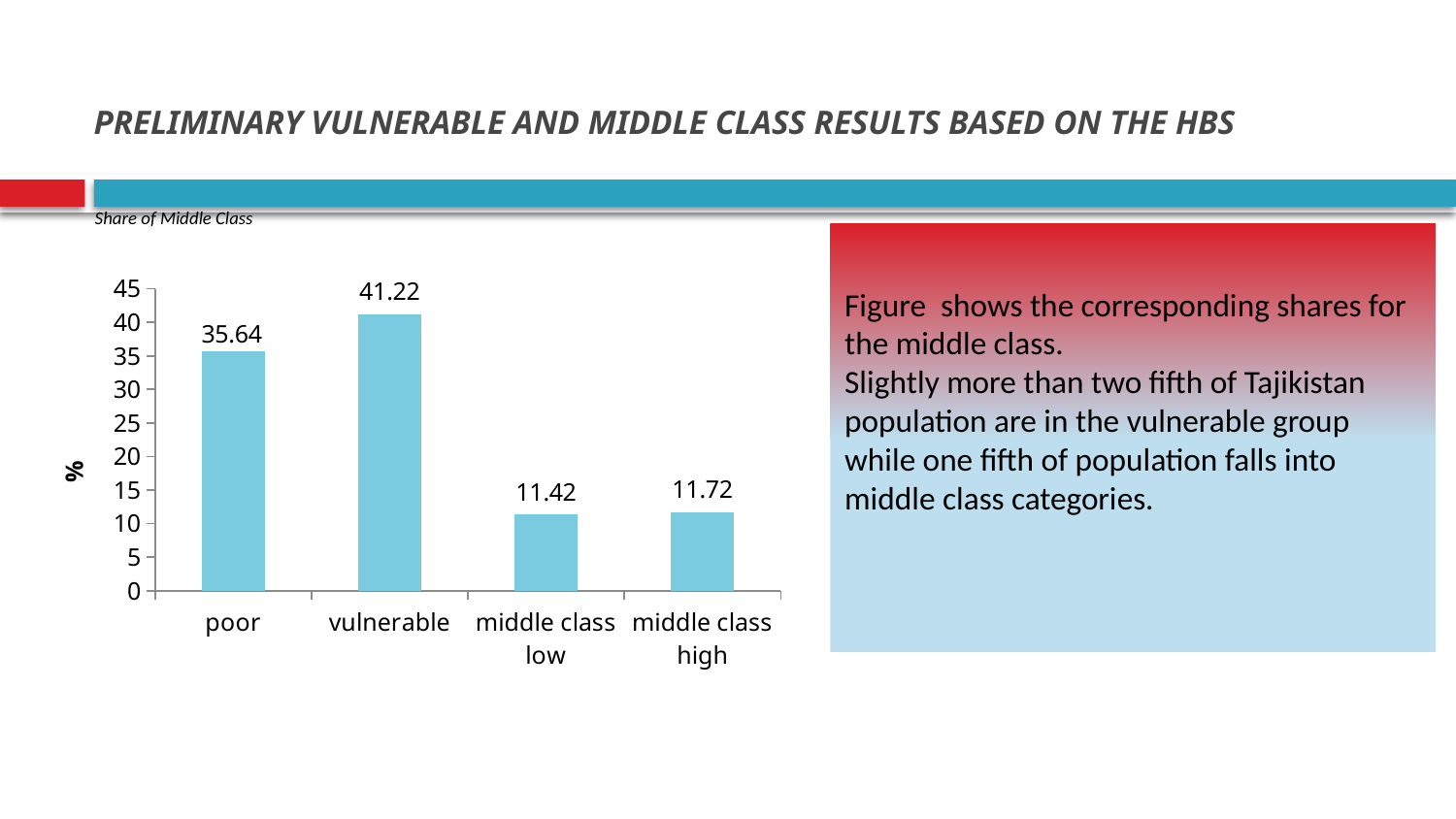
How many categories are shown on the x axis? 4 What is the label on the y axis of the chart? % What is the value for the vulnerable category? 41.22 What is the value for middle class high? 11.72 Is the value for vulnerable greater or less than 40? greater What is the difference between the vulnerable and poor values? 5.58 What is the difference between the middle class high and middle class low values? 0.3 What is the value for middle class low? 11.42 Which is larger, the value for poor or the value for middle class low? poor Which category has the highest value? vulnerable What is the value for the poor category? 35.64 What kind of chart is shown on the slide? bar chart